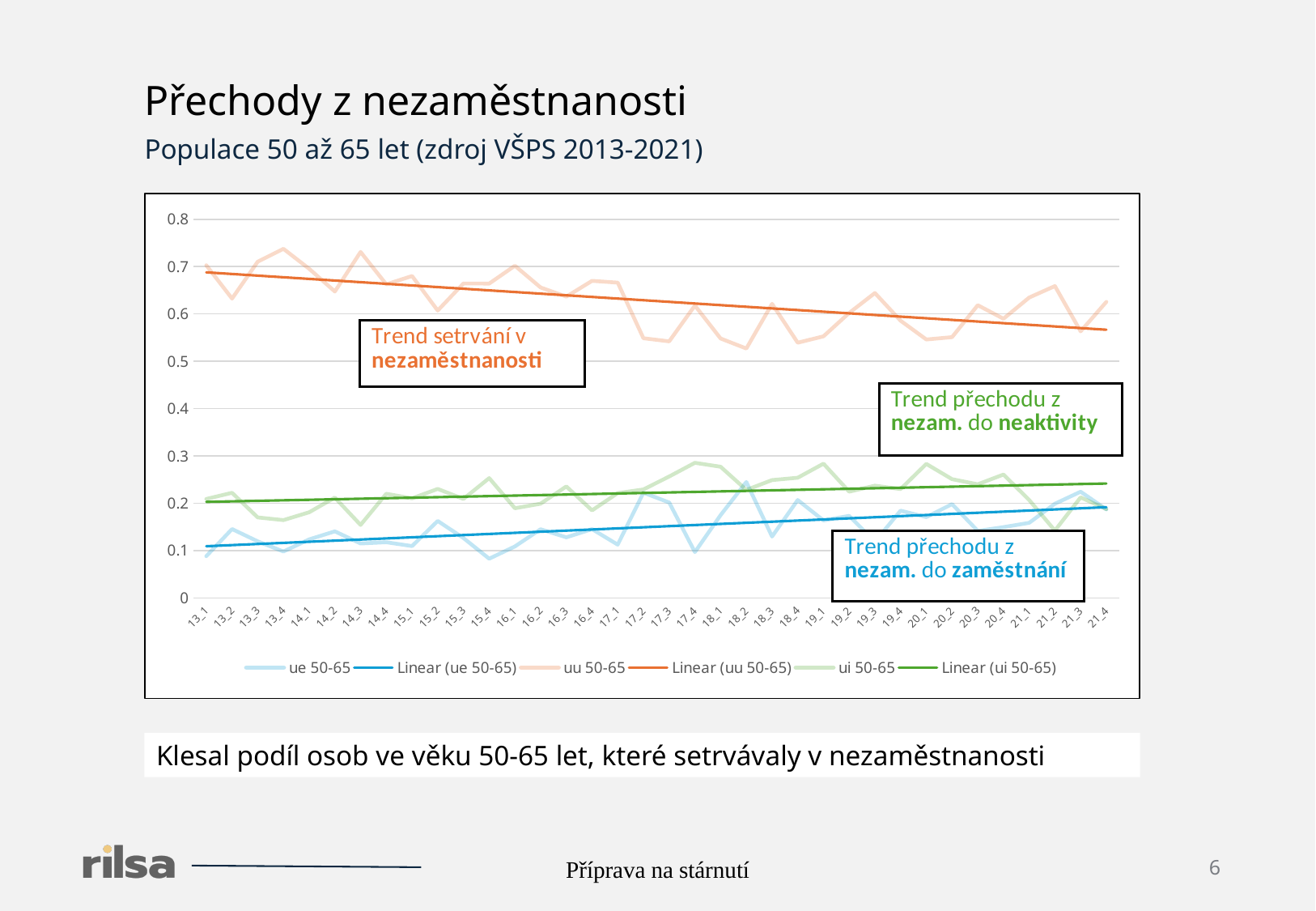
Which series has the highest values throughout the chart: uu 50-65, ue 50-65 or ui 50-65? uu 50-65 How many quarterly points are plotted along the x axis (from 13_1 to 21_4)? 36 Is the value for ue 50-65 at 13_1 greater or less than 0.2? less What is the highest value shown on the chart's y axis? 0.8 Does the linear trend line for uu 50-65 rise or fall along the x axis? fall Does the linear trend line for ui 50-65 rise or fall along the x axis? rise How many series does the chart legend list? 6 Is the value for uu 50-65 at 13_1 greater or less than 0.6? greater Does the linear trend line for ue 50-65 rise or fall along the x axis? rise Is the value for ui 50-65 at 13_1 greater or less than 0.3? less At 13_1, which is larger: the value for uu 50-65 or the value for ue 50-65? uu 50-65 What kind of chart is shown on the slide? line chart